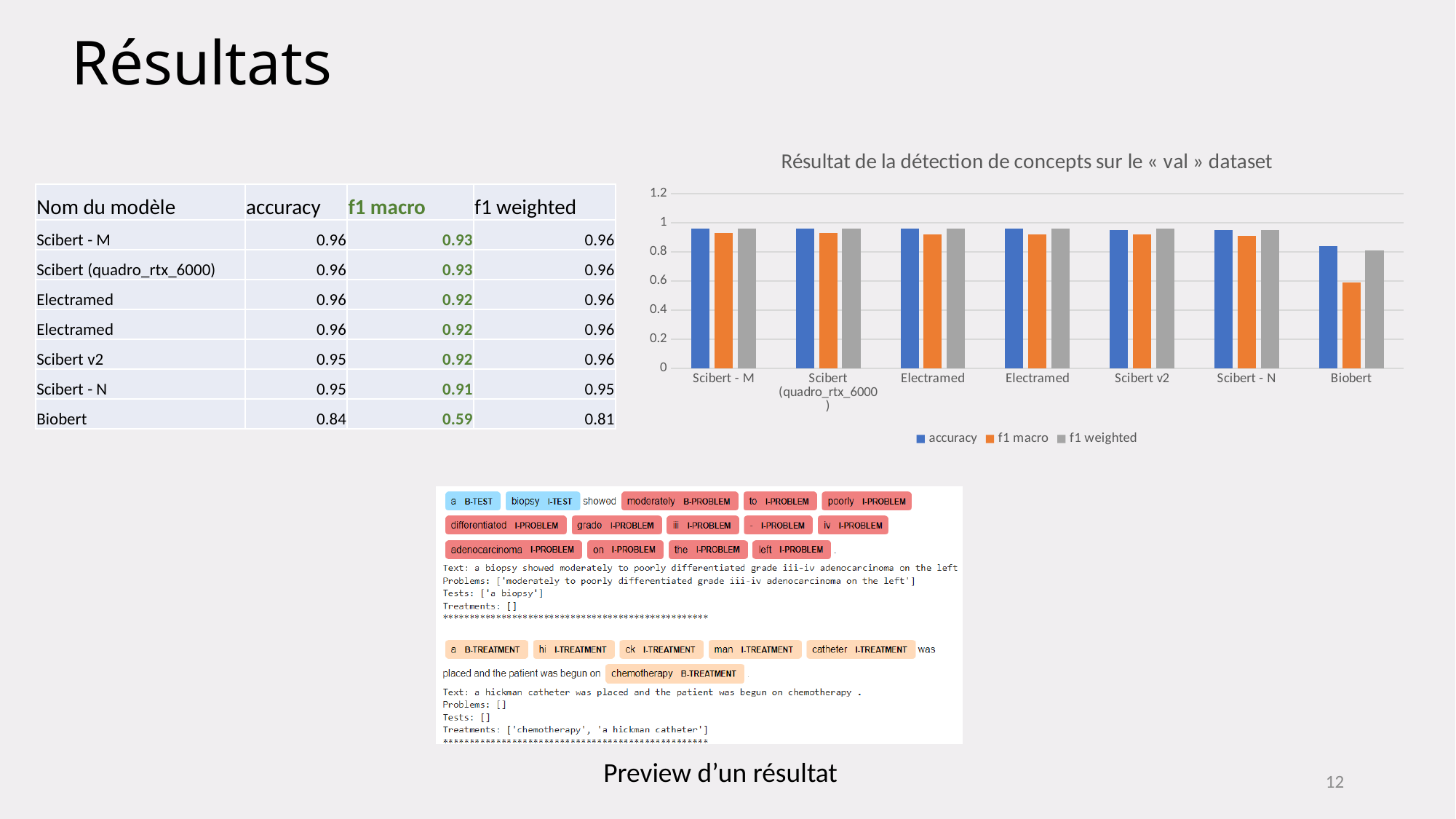
What type of chart is shown on the slide? bar chart What is the title of the chart? Résultat de la détection de concepts sur le « val » dataset What is the f1 macro value for Biobert? 0.59 What is the accuracy value for Scibert - M? 0.96 Is the accuracy value for Scibert - M greater or less than 0.8? greater How many series does the chart legend list? 3 Is the f1 macro value for Biobert greater or less than 0.6? less Which model has the lowest f1 macro value in the chart? Biobert Which series is shown in orange in the chart? f1 macro Is the accuracy value for Biobert greater or less than 1? less How many model categories are shown on the x axis of the chart? 7 Which is larger for Biobert: accuracy or f1 macro? accuracy